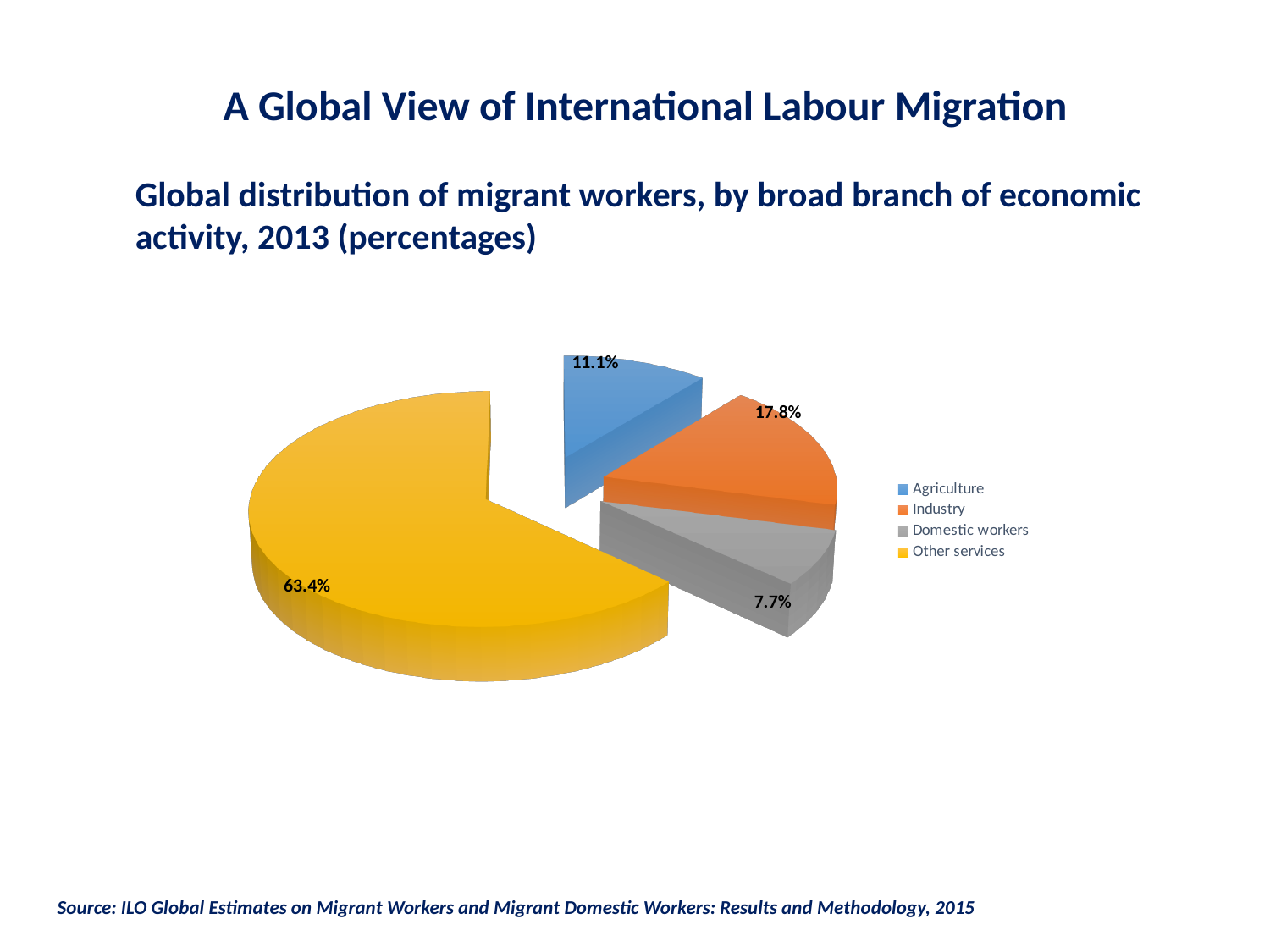
What percentage of migrant workers are in Other services? 63.4% Which branch of economic activity has the largest share of migrant workers? Other services What is the difference in percentage points between Industry and Agriculture? 6.7 What colour is the slice for Other services? yellow Which has a larger share of migrant workers, Agriculture or Domestic workers? Agriculture What percentage of migrant workers are Domestic workers? 7.7% What year does the chart's data refer to? 2013 What kind of chart is shown on the slide? pie chart Which branch of economic activity has the smallest share of migrant workers? Domestic workers What percentage of migrant workers are in Industry? 17.8% How many categories does the pie chart show? 4 What percentage of migrant workers are in Agriculture? 11.1%